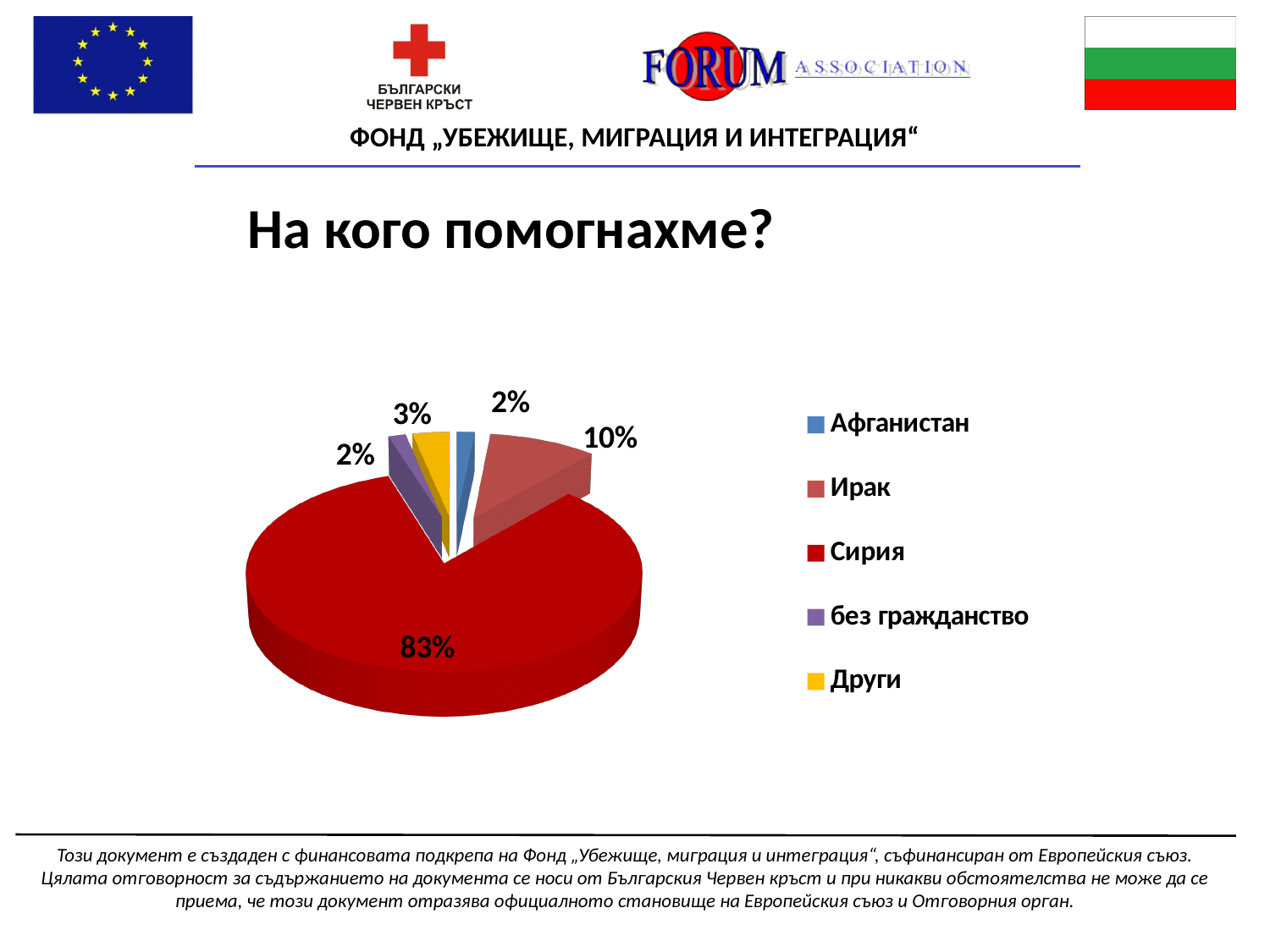
Which category has the largest share of the pie chart? Сирия What percentage of the pie chart is Афганистан? 2% How many categories does the pie chart show? 5 What percentage of the pie chart is Други? 3% What is the combined share of Ирак and Други? 13% What is the difference in percentage points between Сирия and Ирак? 73 What percentage of the pie chart is без гражданство? 2% Which has a larger share, Ирак or Други? Ирак What percentage of the pie chart is Ирак? 10% What percentage of the pie chart is Сирия? 83% What is the title of the chart on the slide? На кого помогнахме? What kind of chart is shown on the slide? Pie chart